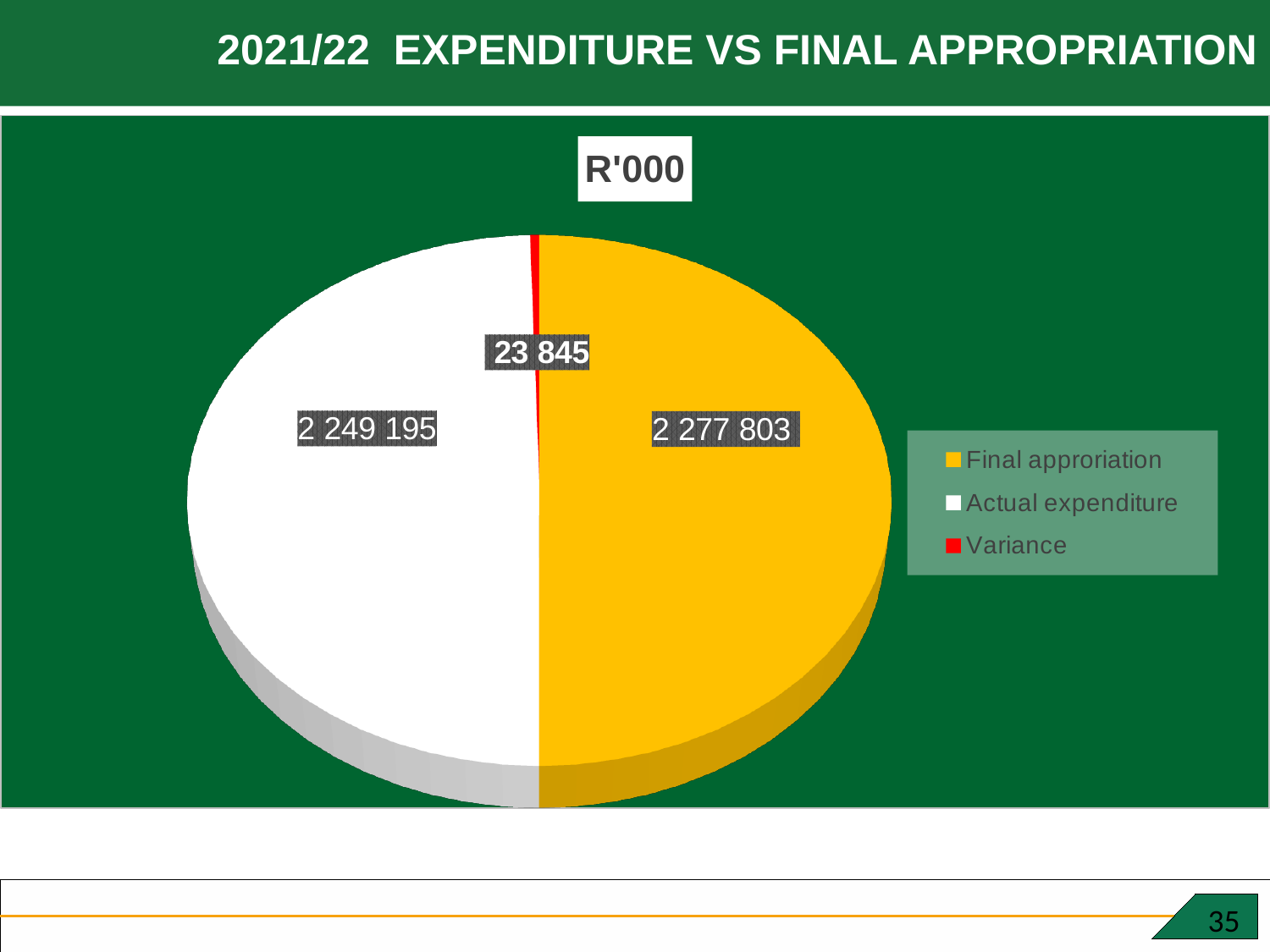
How many entries does the legend list? 3 What is the difference between Final appropriation and Actual expenditure? 28 608 Which slice of the pie chart has the lowest value? Variance What is the value for Actual expenditure in the pie chart? 2 249 195 What colour represents Variance in the pie chart? Red Which is larger, Final appropriation or Actual expenditure? Final appropriation What kind of chart is shown on the slide? Pie chart What is the value for Final appropriation in the pie chart? 2 277 803 Which is larger, Actual expenditure or Variance? Actual expenditure How many slices does the pie chart have? 3 Which slice of the pie chart has the highest value? Final appropriation What is the value for Variance in the pie chart? 23 845